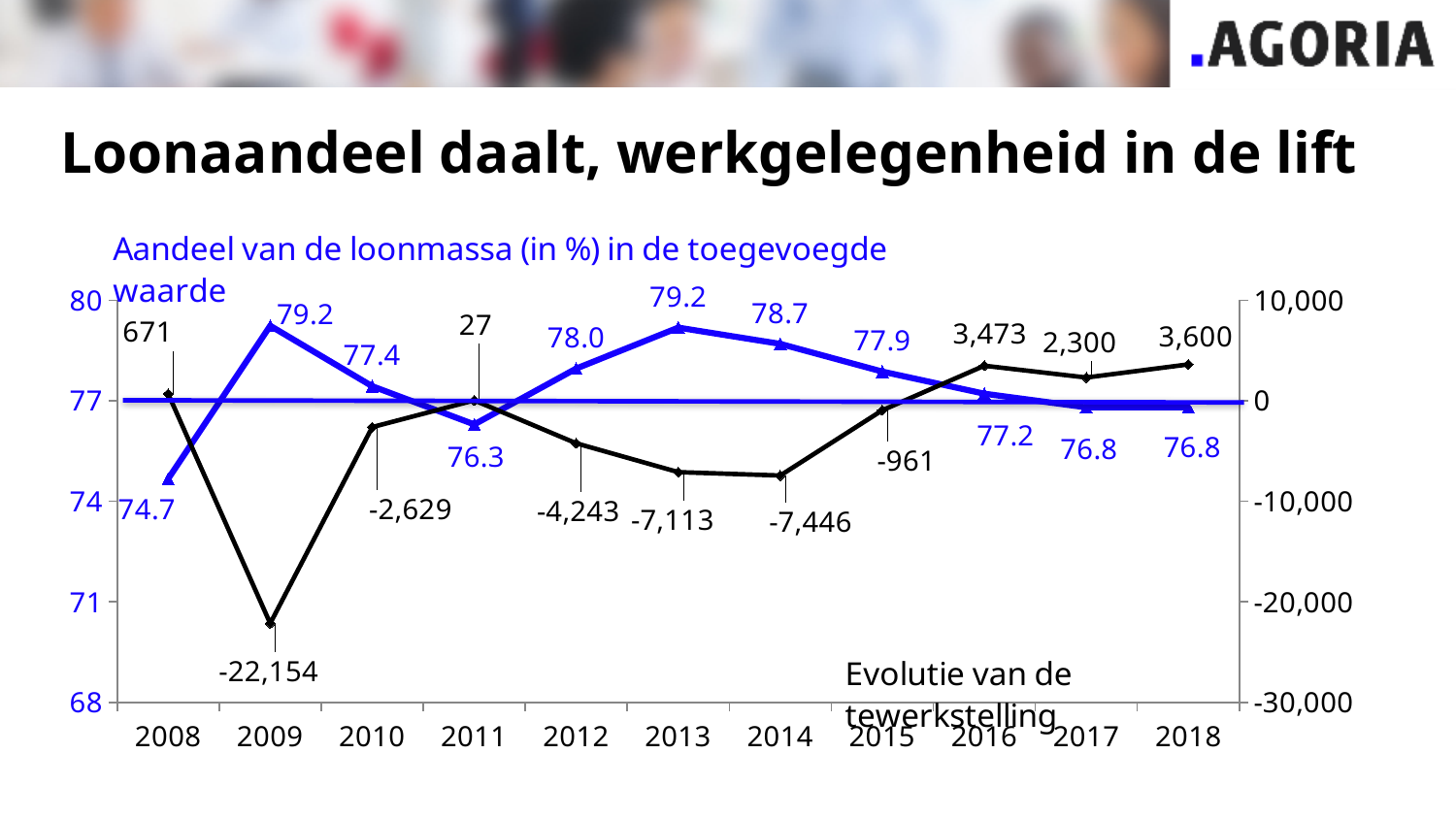
What is the difference between the 'Evolutie van de tewerkstelling' values for 2016 and 2017? 1,173 Which year has the larger 'Evolutie van de tewerkstelling' value, 2013 or 2015? 2015 What is the value of the 'Aandeel van de loonmassa' series in 2008? 74.7 What is the value of the 'Evolutie van de tewerkstelling' series in 2009? -22,154 What type of chart is shown on the slide? Line chart Does the 'Aandeel van de loonmassa' series rise or fall from 2013 to 2018? Fall What is the value of the 'Aandeel van de loonmassa' series in 2014? 78.7 In which year is the 'Evolutie van de tewerkstelling' series at its lowest? 2009 In which year is the 'Aandeel van de loonmassa' series at its lowest? 2008 What is the value of the 'Evolutie van de tewerkstelling' series in 2018? 3,600 How many years are shown on the x axis? 11 In which year is the 'Evolutie van de tewerkstelling' series at its highest? 2018